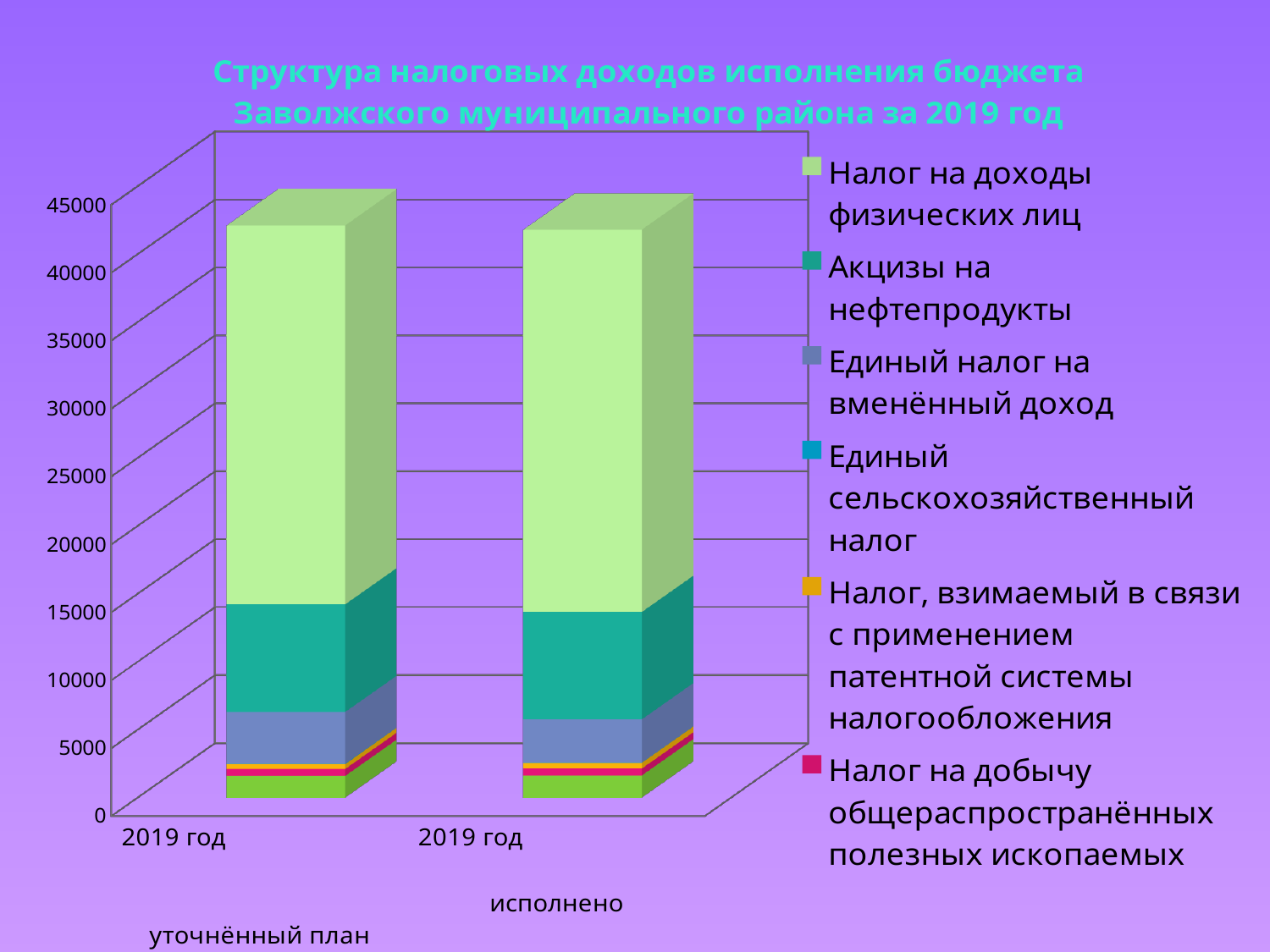
How many series does the legend list? 6 Is the 'Налог на доходы физических лиц' segment in the 'исполнено' bar greater or less than 20000? greater Which series forms the second-largest segment in the 'уточнённый план' bar? Акцизы на нефтепродукты Which series makes up the largest segment of each stacked bar? Налог на доходы физических лиц What is the highest value shown on the vertical axis? 45000 Is the total of the 'уточнённый план' bar greater or less than 40000? greater What kind of chart is shown on the slide? Stacked bar chart What is the title of the chart? Структура налоговых доходов исполнения бюджета Заволжского муниципального района за 2019 год Is the total of the 'исполнено' bar greater or less than 45000? less How many bars are plotted in the chart? 2 Which series is shown in light green in the legend? Налог на доходы физических лиц